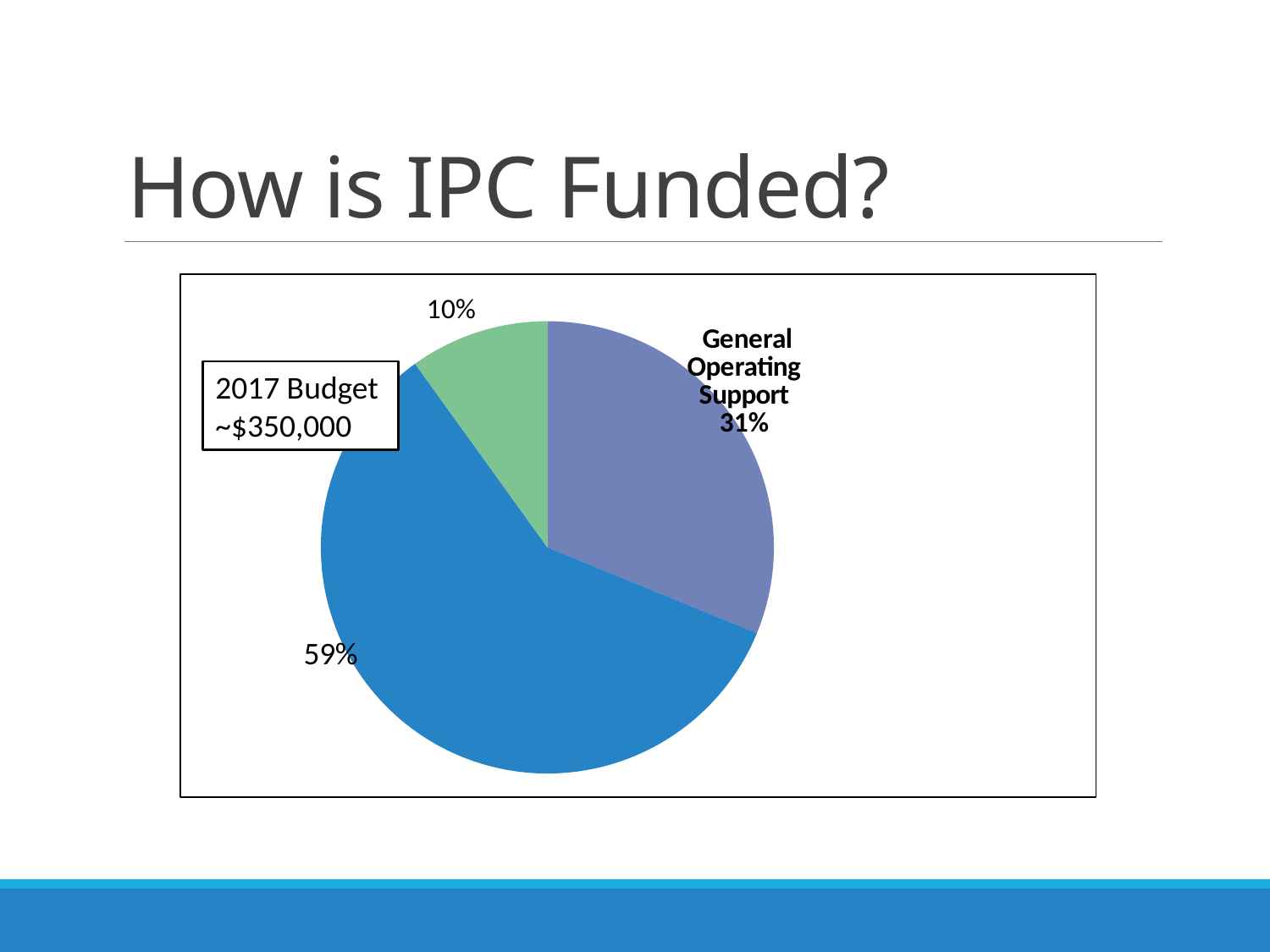
Is the General Operating Support slice greater or less than 50% of the pie? less What share of the pie does the blue slice represent? 59% How many slices does the pie chart have? 3 What is the title of the slide containing the pie chart? How is IPC Funded? Which is larger: the General Operating Support slice or the green slice? General Operating Support What 2017 budget figure is shown in the text box next to the pie chart? ~$350,000 What is the difference in percentage points between the largest slice (59%) and the General Operating Support slice? 28 What kind of chart is shown on the slide? pie chart What percentage is shown on the smallest slice of the pie chart? 10% What percentage is shown on the largest slice of the pie chart? 59% What share of the pie is labelled General Operating Support? 31% What share of the pie does the green slice represent? 10%